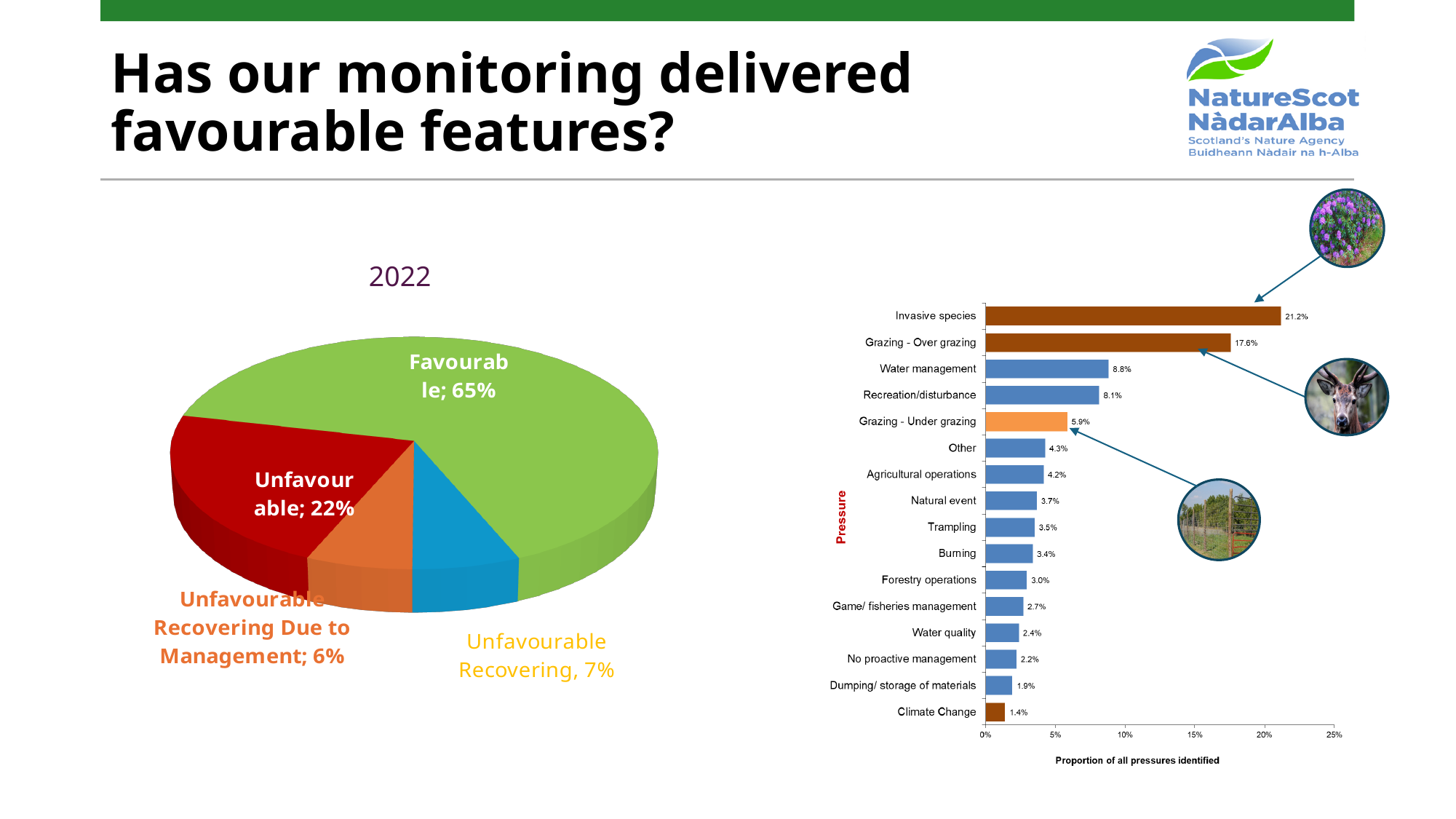
In the 2022 pie chart, which category has the largest slice? Favourable In the 2022 pie chart, what is the difference between the Favourable and Unfavourable shares? 43% In the bar chart on the right, which is larger: Water management or Recreation/disturbance? Water management In the bar chart on the right, what is the difference between Invasive species and Grazing - Over grazing? 3.6% In the 2022 pie chart, how many slices are there? 4 In the 2022 pie chart, what share is labelled Unfavourable? 22% In the bar chart on the right, what is the value for Invasive species? 21.2% In the bar chart on the right, what is the value for Grazing - Under grazing? 5.9% In the 2022 pie chart, what share is labelled Unfavourable Recovering Due to Management? 6% In the bar chart on the right, which pressure has the lowest proportion? Climate Change In the 2022 pie chart, what share is labelled Favourable? 65% In the bar chart on the right, what is the x-axis title? Proportion of all pressures identified